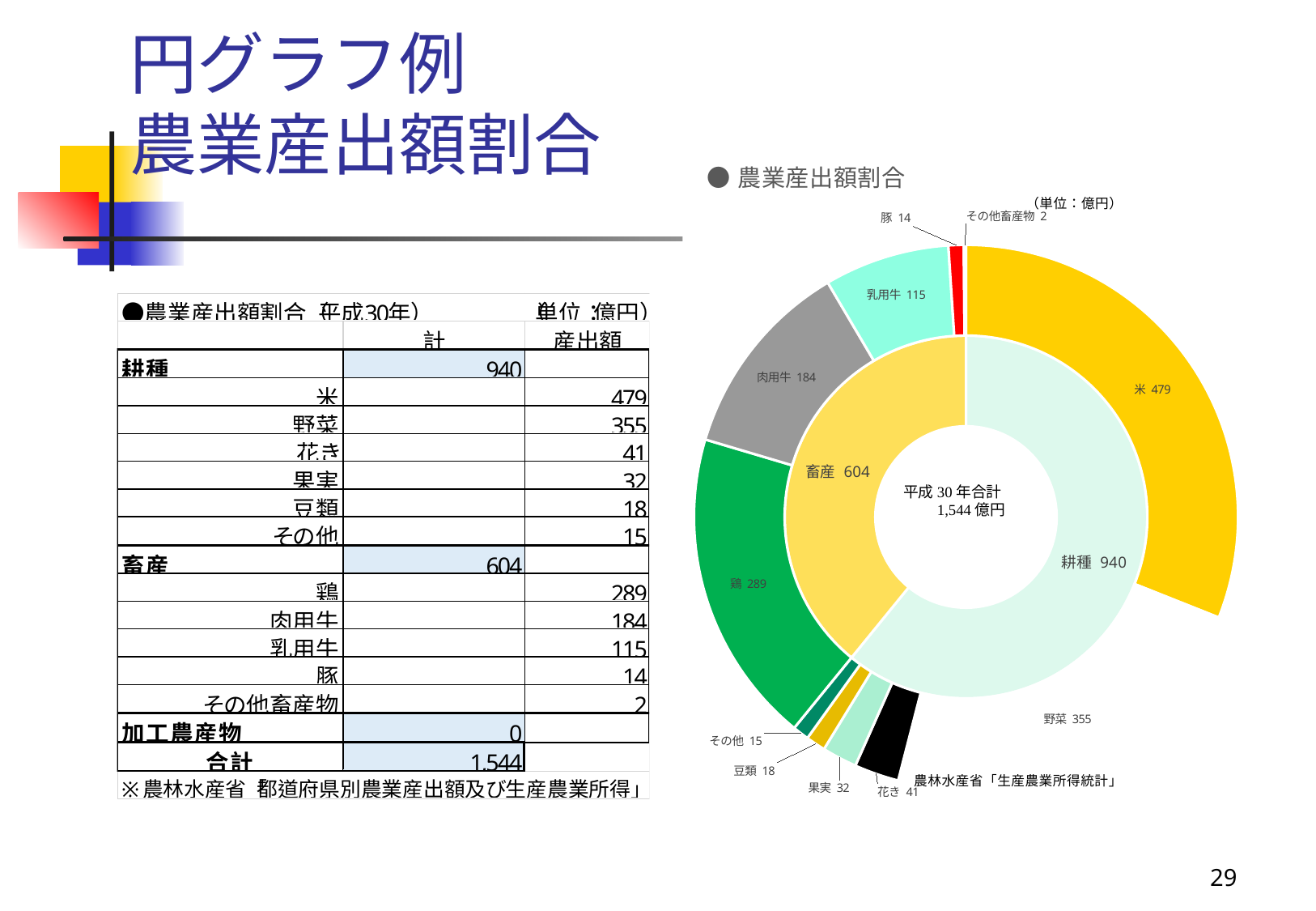
What type of chart is shown on the slide? doughnut chart Which is larger, the value for 野菜 or the value for 鶏? 野菜 Which category in the outer ring has the highest value? 米 What is the value for 鶏 in the chart? 289 What unit is stated for the values in the chart? 億円 What is the value for 米 in the chart? 479 Which category in the outer ring has the lowest value? その他畜産物 What is the value for 耕種 in the inner ring of the chart? 940 What total is shown in the centre of the chart? 1,544 億円 What is the value for 乳用牛 in the chart? 115 What is the title of the chart? 農業産出額割合 What is the difference between the values for 耕種 and 畜産? 336